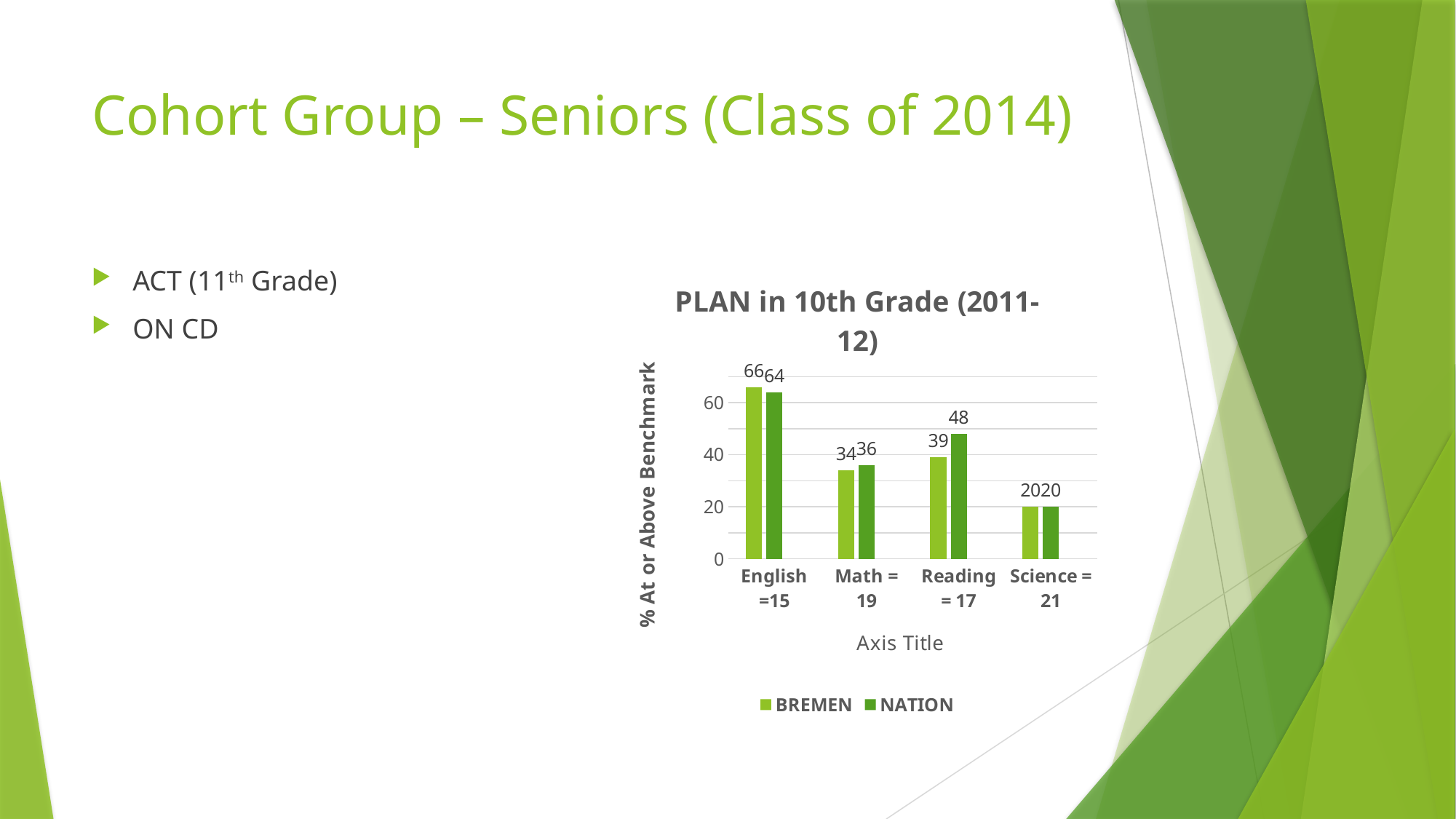
What is the NATION value for Science = 21? 20 What is the NATION value for Reading = 17? 48 What is the difference between the NATION and BREMEN values for Reading = 17? 9 How many categories are shown on the x axis? 4 Which category has the lowest NATION value? Science = 21 Which category has the highest BREMEN value? English =15 What is the BREMEN value for English =15? 66 What is the title of the chart? PLAN in 10th Grade (2011-12) How many series does the legend list? 2 What kind of chart is shown on the slide? Bar chart What is the BREMEN value for Math = 19? 34 Which is larger for Math = 19, the BREMEN value or the NATION value? NATION